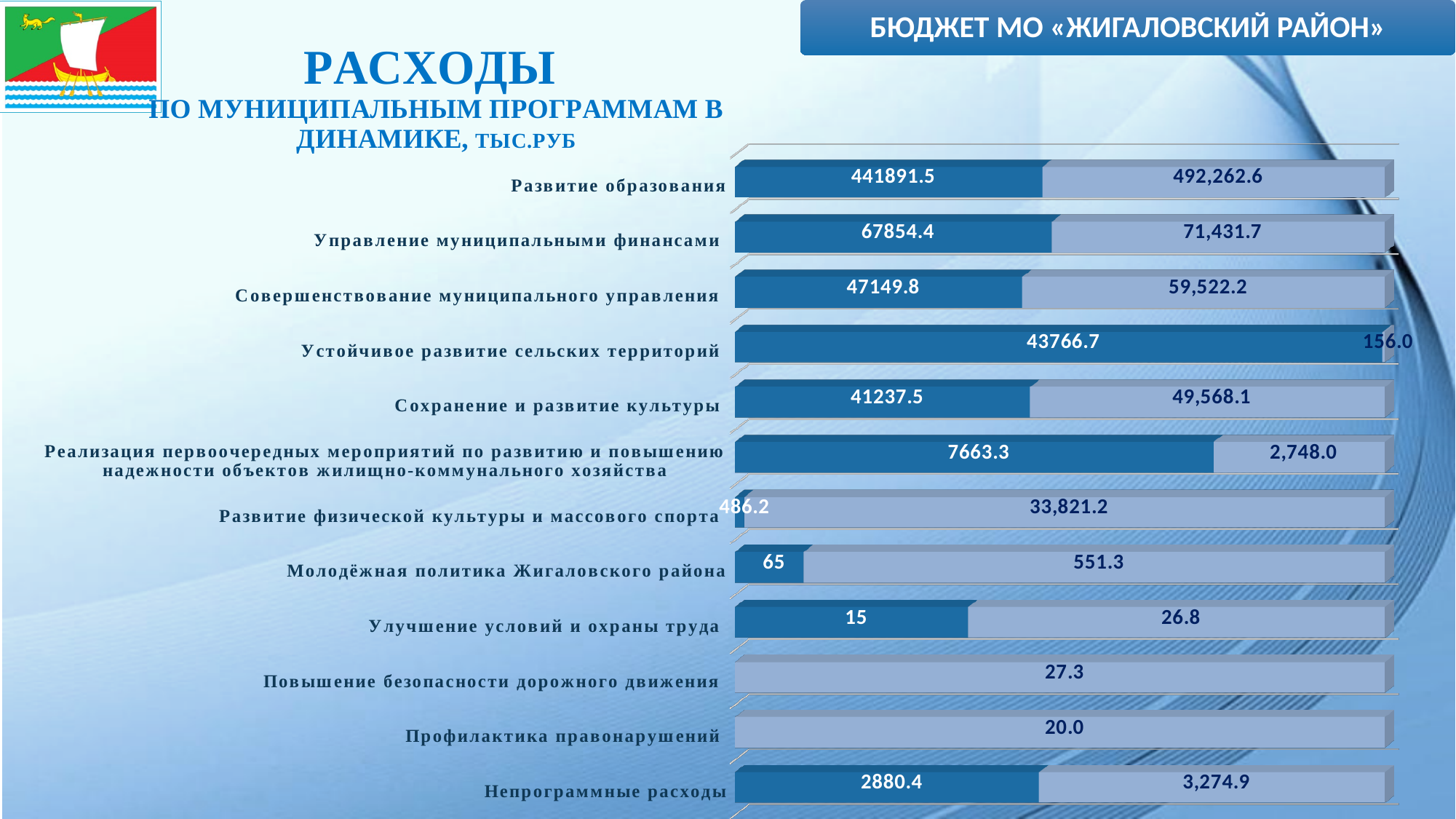
What type of chart is shown on the slide? Stacked horizontal bar chart Which category has the lowest light blue value? Профилактика правонарушений What is the light blue value for Развитие физической культуры и массового спорта? 33,821.2 Which category has the highest dark blue value? Развитие образования What is the light blue value for Устойчивое развитие сельских территорий? 156.0 What is the dark blue value for Молодёжная политика Жигаловского района? 65 What is the dark blue value for Развитие образования? 441891.5 How many categories (programmes) are listed on the chart? 12 What is the light blue value for Развитие образования? 492,262.6 What is the value shown for Профилактика правонарушений? 20.0 What is the difference between the light blue and dark blue values for Улучшение условий и охраны труда? 11.8 For Реализация первоочередных мероприятий по развитию и повышению надежности объектов жилищно-коммунального хозяйства, which is larger: the dark blue value or the light blue value? The dark blue value (7663.3)